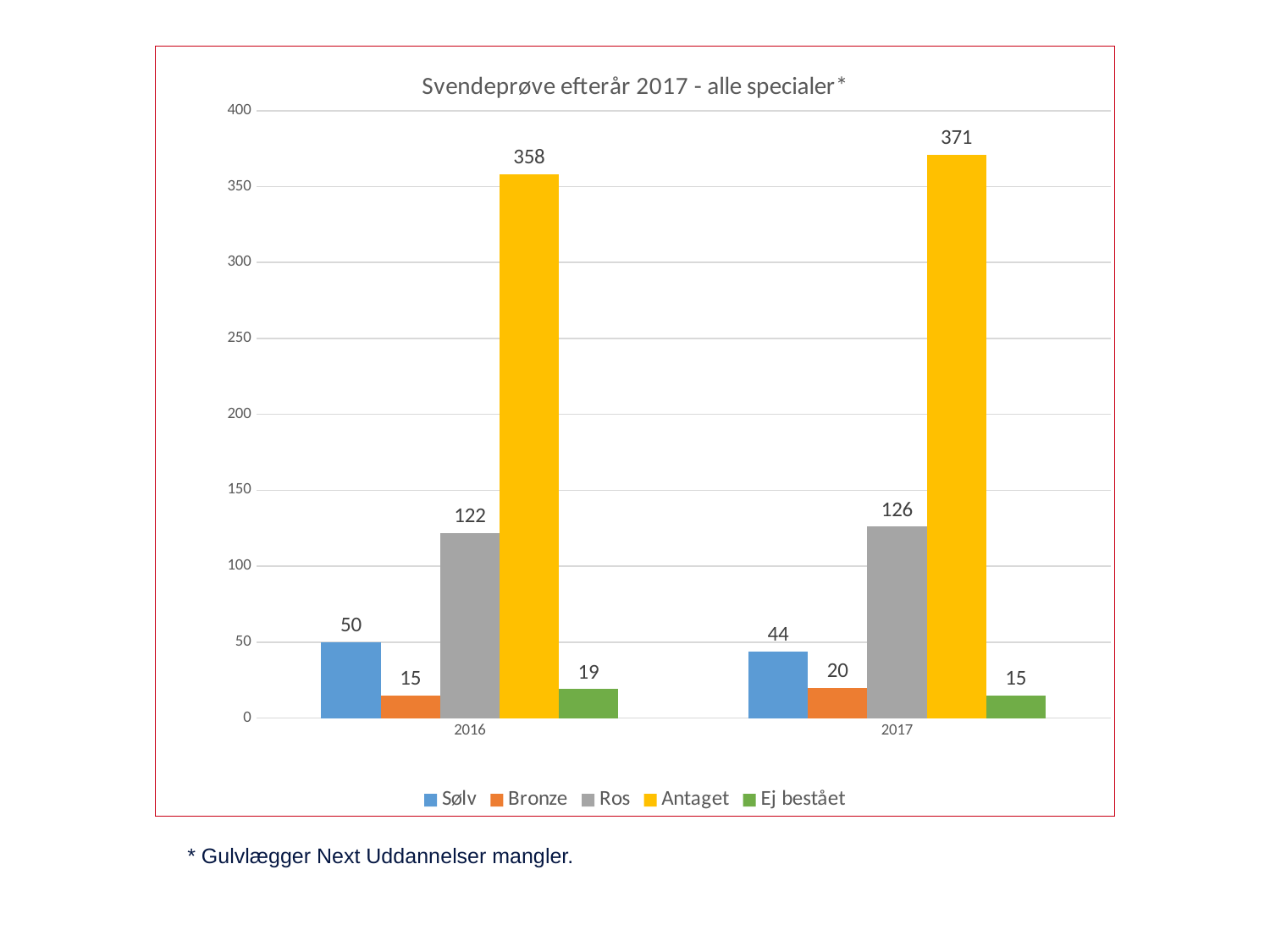
What is the value for Sølv in 2016? 50 What kind of chart is this? Bar chart What is the title of the chart? Svendeprøve efterår 2017 - alle specialer* Which series has the lowest value in 2017? Ej bestået How many series does the legend list? 5 What is the difference between Ros in 2017 and Ros in 2016? 4 What is the value for Antaget in 2017? 371 How many year categories are shown on the x axis? 2 What is the difference between the Antaget values for 2017 and 2016? 13 Which is larger, Bronze in 2016 or Bronze in 2017? Bronze in 2017 Which series has the highest value in 2016? Antaget What is the value for Ej bestået in 2017? 15